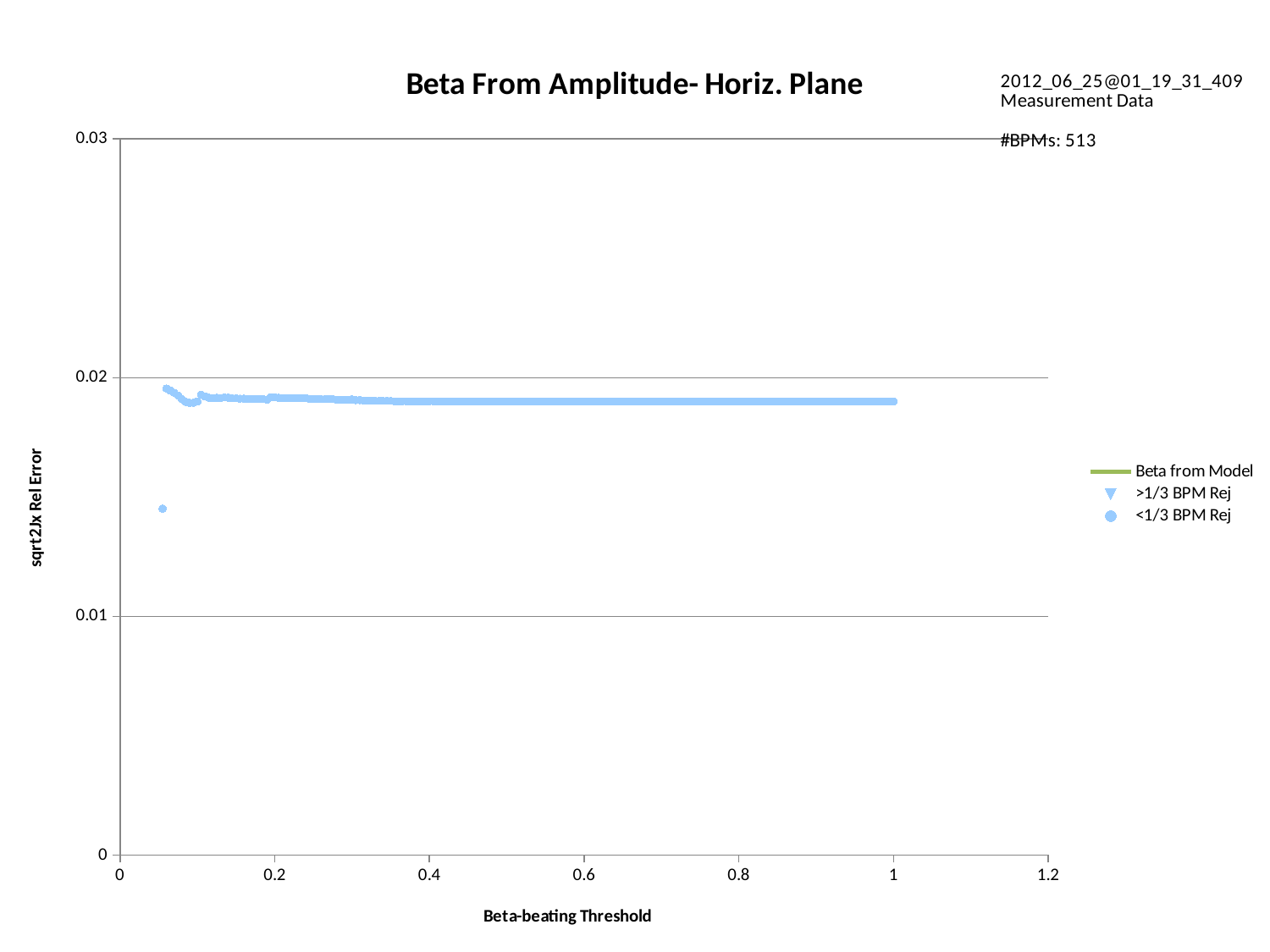
How many BPMs are stated on the slide? 513 How many series does the legend list? 3 Is the value of the main band of plotted points at a Beta-beating Threshold of 0.6 greater or less than 0.01? greater Is the value of the main band of plotted points at a Beta-beating Threshold of 0.6 greater or less than 0.02? less Is the isolated point near a Beta-beating Threshold of 0.05 higher or lower than the main band of points? lower What is the title of the chart? Beta From Amplitude- Horiz. Plane What is the highest tick value shown on the y axis? 0.03 As the Beta-beating Threshold increases from 0.2 to 1, do the plotted values rise sharply, fall sharply, or stay roughly flat? stay roughly flat What kind of chart is shown on the slide? scatter chart Is the lowest plotted point on the chart greater or less than 0.01? greater What is the highest tick value shown on the x axis? 1.2